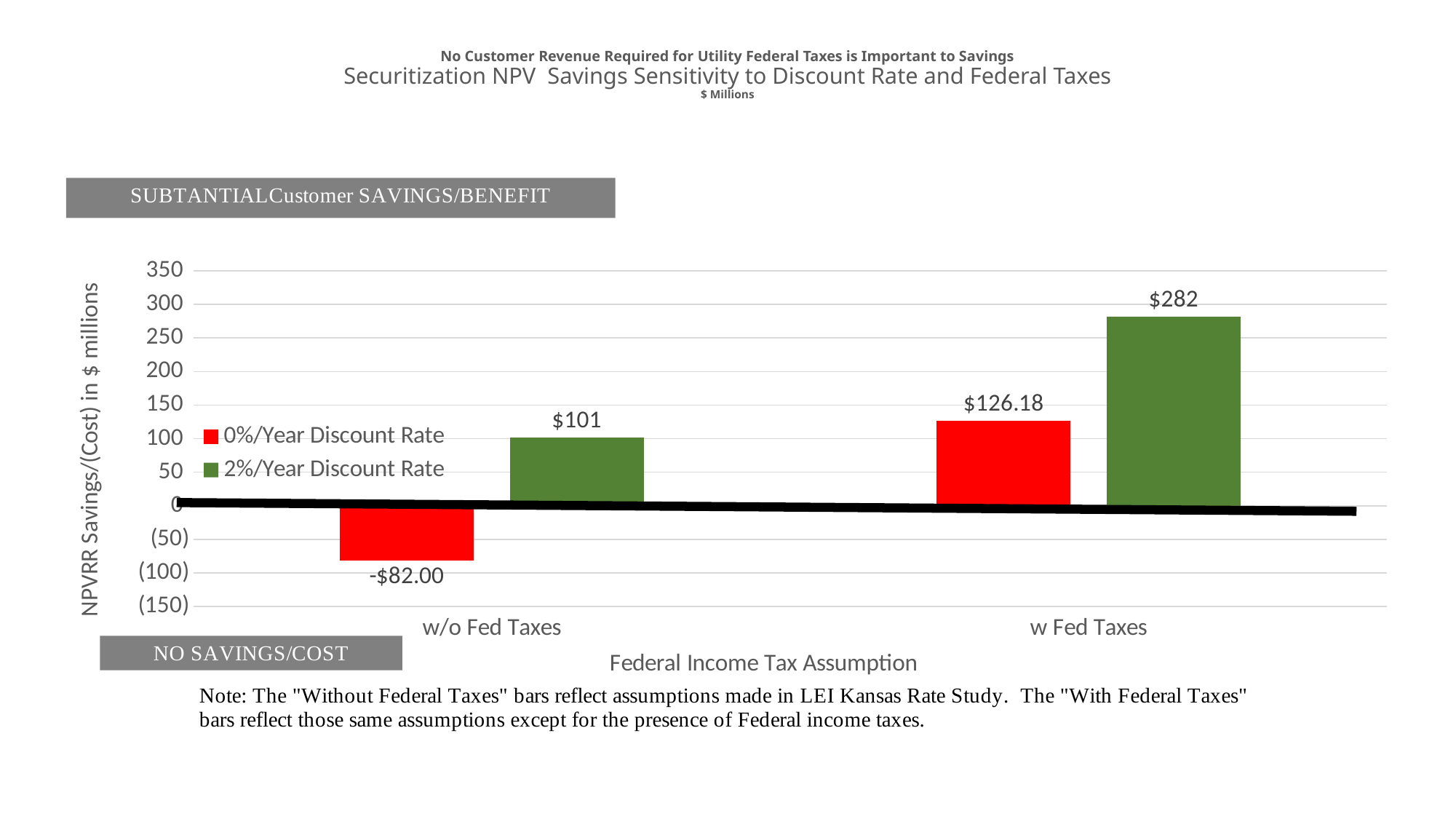
Which bar has the lowest value on the chart? 0%/Year Discount Rate, w/o Fed Taxes What kind of chart is shown on the slide? Bar chart What is the difference between the 2%/Year Discount Rate values for w Fed Taxes and w/o Fed Taxes? $181 How many series does the legend list? 2 What is the x-axis title of the chart? Federal Income Tax Assumption How many categories are shown on the x axis? 2 What is the value for the 0%/Year Discount Rate series in the w/o Fed Taxes category? -$82.00 Which bar has the highest value on the chart? 2%/Year Discount Rate, w Fed Taxes Which is larger: the 0%/Year Discount Rate value for w Fed Taxes or the 2%/Year Discount Rate value for w/o Fed Taxes? 0%/Year Discount Rate value for w Fed Taxes What is the value for the 2%/Year Discount Rate series in the w Fed Taxes category? $282 What is the value for the 2%/Year Discount Rate series in the w/o Fed Taxes category? $101 What is the value for the 0%/Year Discount Rate series in the w Fed Taxes category? $126.18